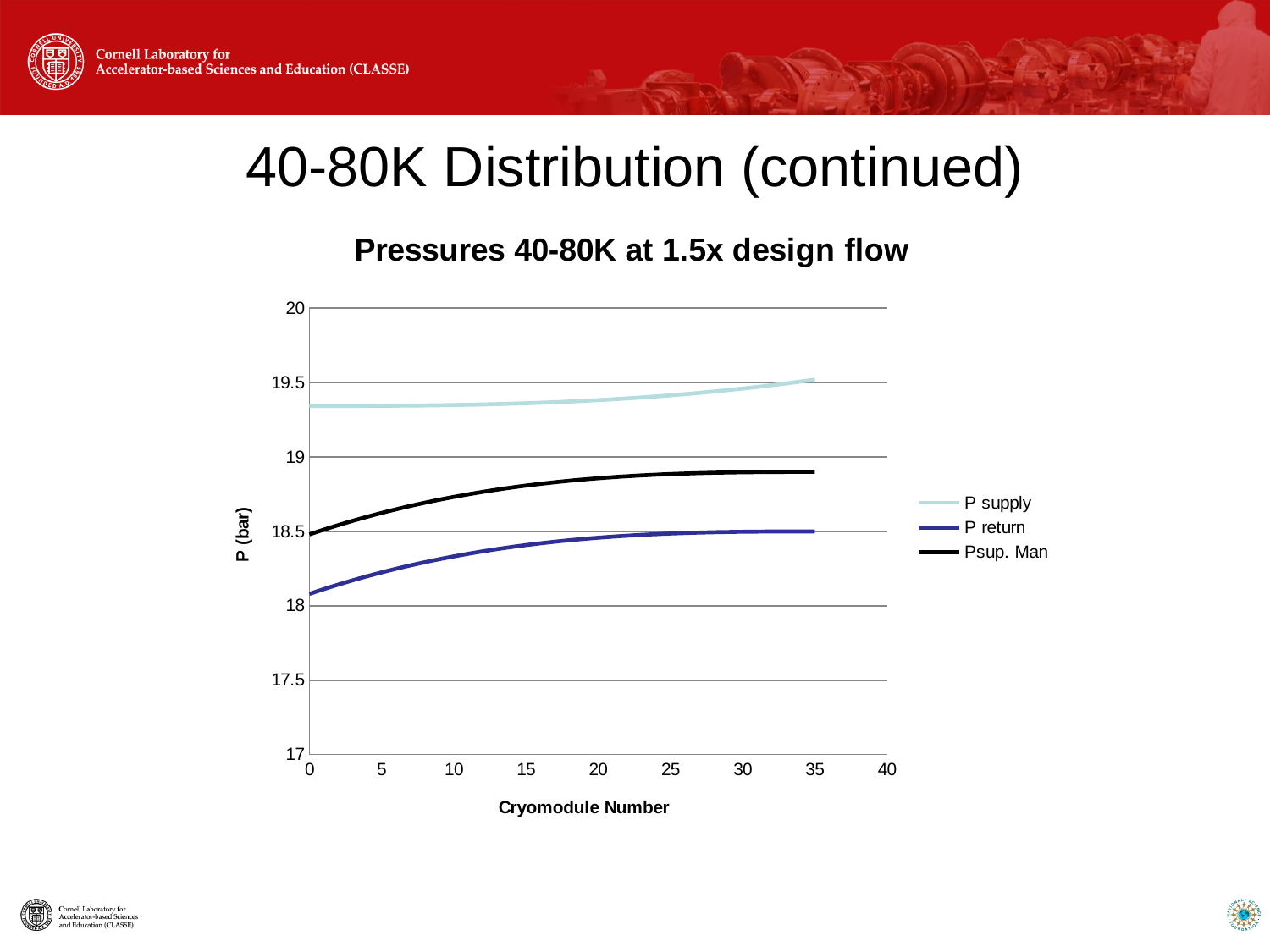
How many series does the legend list? 3 Is the Psup. Man value at cryomodule number 35 greater or less than 19? less Does the P return pressure rise or fall as the cryomodule number increases? rise Which series has the highest pressure across the cryomodule range? P supply Does the Psup. Man pressure rise or fall as the cryomodule number increases? rise What kind of chart is shown on the slide? line chart At cryomodule number 20, which is larger: P supply or P return? P supply What is the label of the x axis? Cryomodule Number Which series has the lowest pressure across the cryomodule range? P return What is the title of the chart? Pressures 40-80K at 1.5x design flow Is the P return value at cryomodule number 0 greater or less than 18.5? less Is the P supply value at cryomodule number 0 greater or less than 19? greater